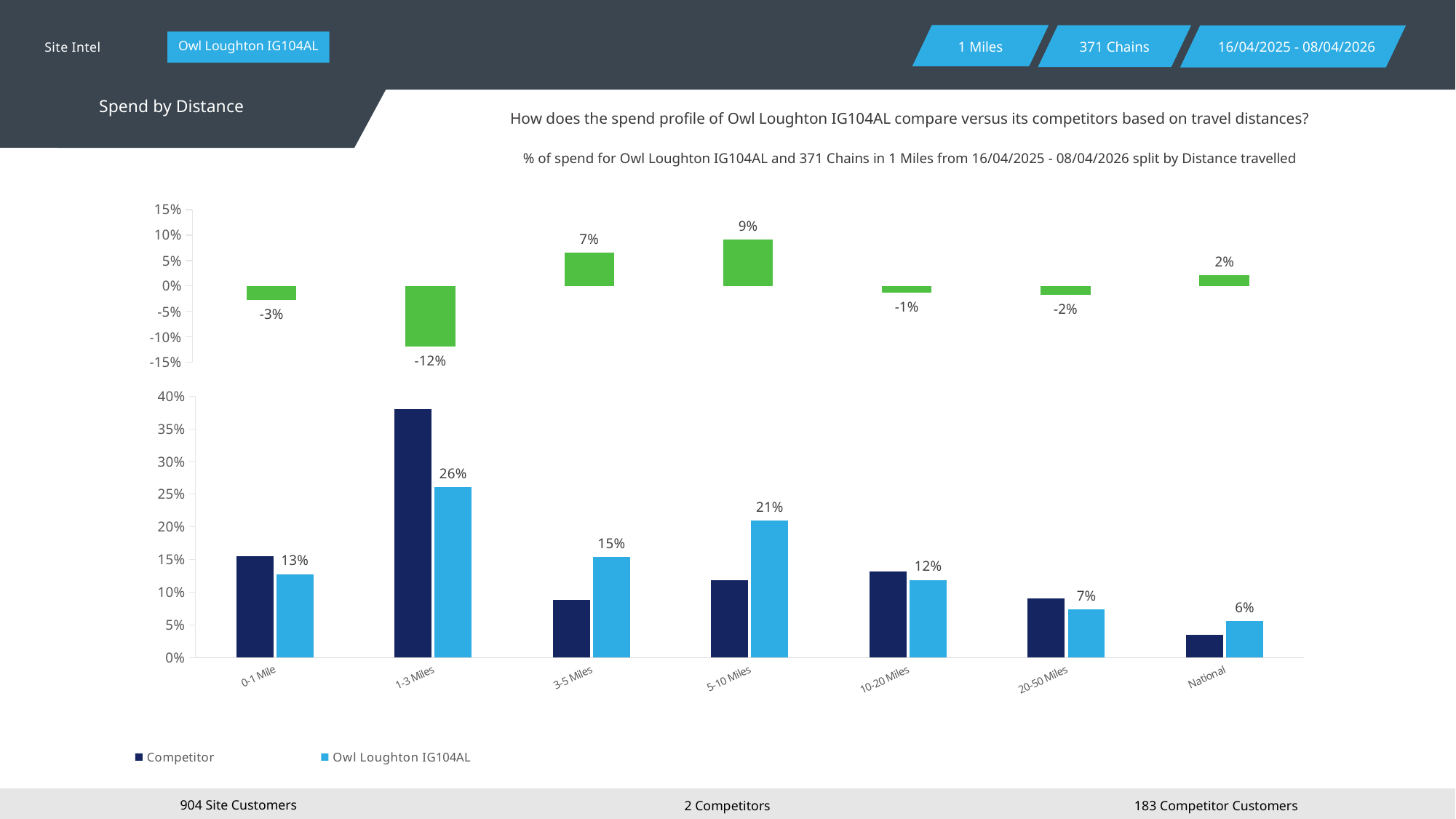
In the top chart, which distance band has the highest value? 5-10 Miles In the top chart, what is the value shown for 1-3 Miles? -12% In the bottom chart, is the Competitor value for 1-3 Miles greater or less than 35%? greater How many series does the legend of the bottom chart list? 2 In the bottom chart, what is the value for Owl Loughton IG104AL at 5-10 Miles? 21% How many distance bands are shown on the x axis of the bottom chart? 7 In the top chart, which distance band has the lowest value? 1-3 Miles In the bottom chart, what is the difference between the Owl Loughton IG104AL values for 1-3 Miles and 5-10 Miles? 5% In the bottom chart, at 0-1 Mile, which series has the larger value: Competitor or Owl Loughton IG104AL? Competitor In the bottom chart, what is the value for Owl Loughton IG104AL at 1-3 Miles? 26% What kind of chart is the bottom chart? bar chart In the bottom chart, which distance band has the highest value for Owl Loughton IG104AL? 1-3 Miles